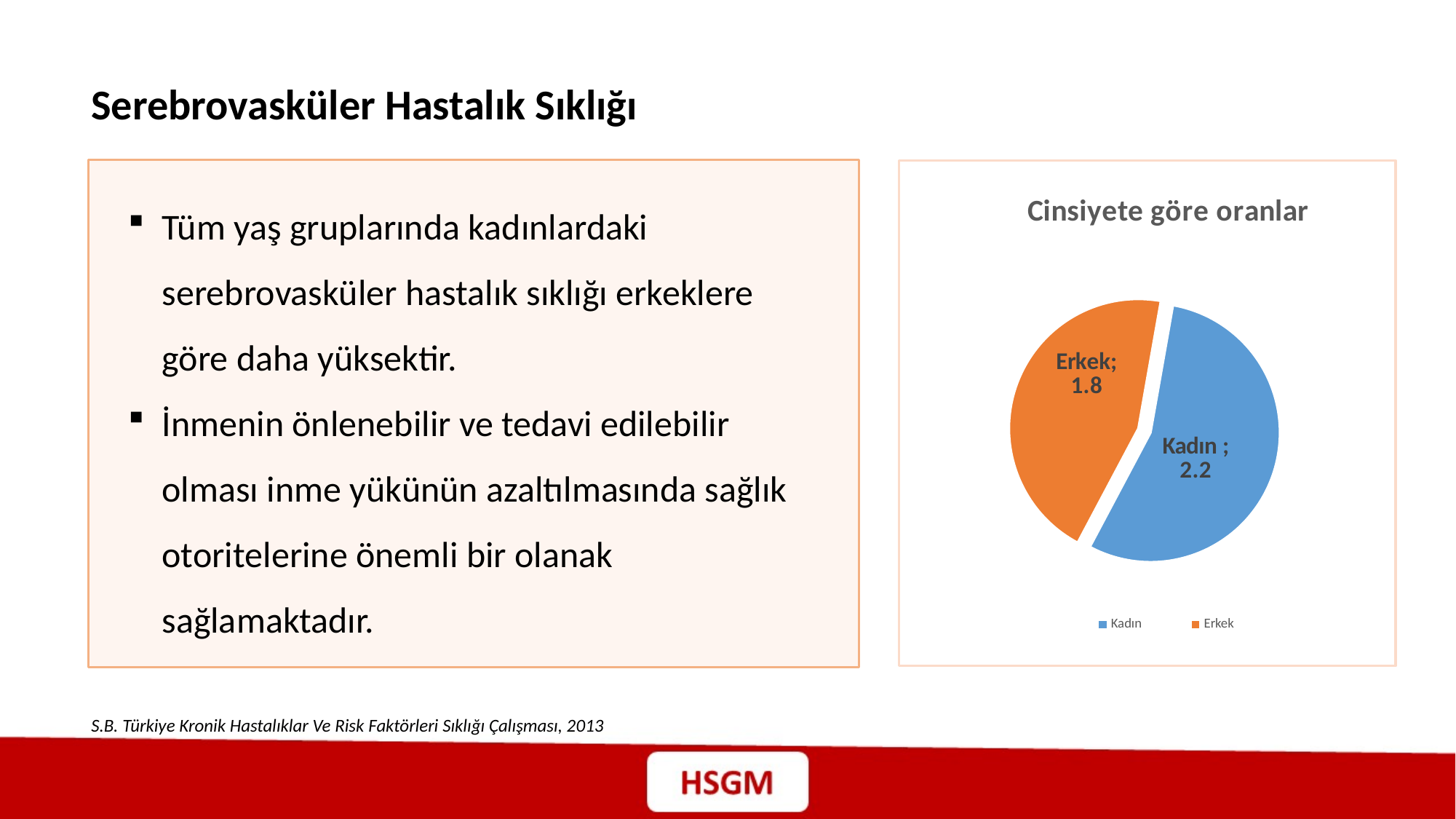
What colour is the Erkek slice in the pie chart? Orange Which is larger in the pie chart, Kadın or Erkek? Kadın What is the difference between the Kadın and Erkek values in the pie chart? 0.4 How many entries does the legend of the pie chart list? 2 What kind of chart is shown on the slide? Pie chart What is the value for Erkek in the pie chart? 1.8 How many slices does the pie chart have? 2 Which category has the smallest slice in the pie chart? Erkek What is the title of the chart on the slide? Cinsiyete göre oranlar What is the value for Kadın in the pie chart? 2.2 What share of the pie does the Kadın slice represent? 55% Which category has the largest slice in the pie chart? Kadın